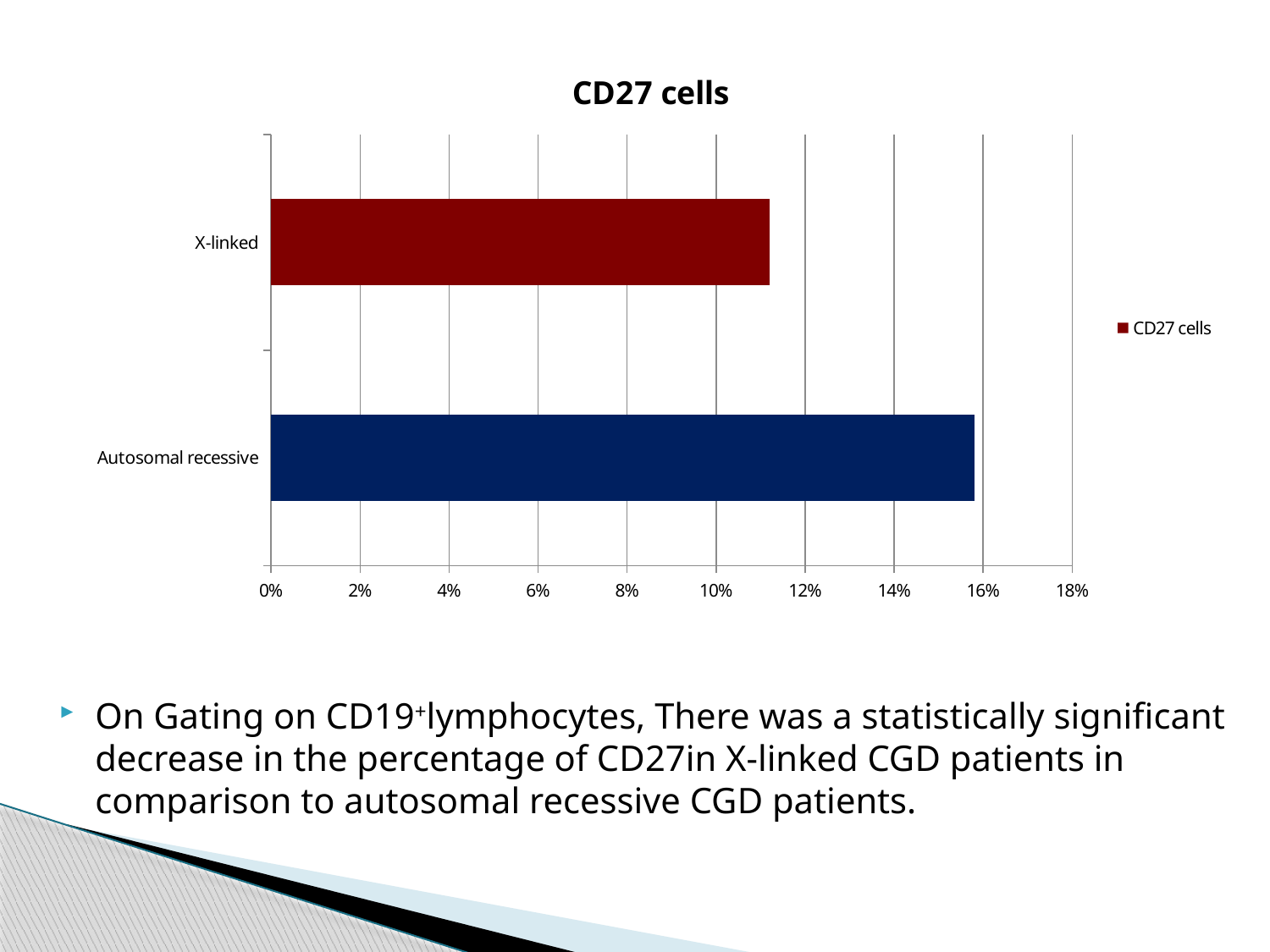
What kind of chart is shown on the slide? bar chart How many categories are plotted in the chart? 2 Which category has the lowest value for CD27 cells? X-linked How many series does the legend list? 1 What colour is the bar for X-linked? dark red What is the title of the chart? CD27 cells Is the value for Autosomal recessive greater or less than 14%? greater Which category has the highest value for CD27 cells? Autosomal recessive Is the value for Autosomal recessive greater or less than 16%? less Is the value for X-linked greater or less than 12%? less Which is larger, the value for X-linked or the value for Autosomal recessive? Autosomal recessive